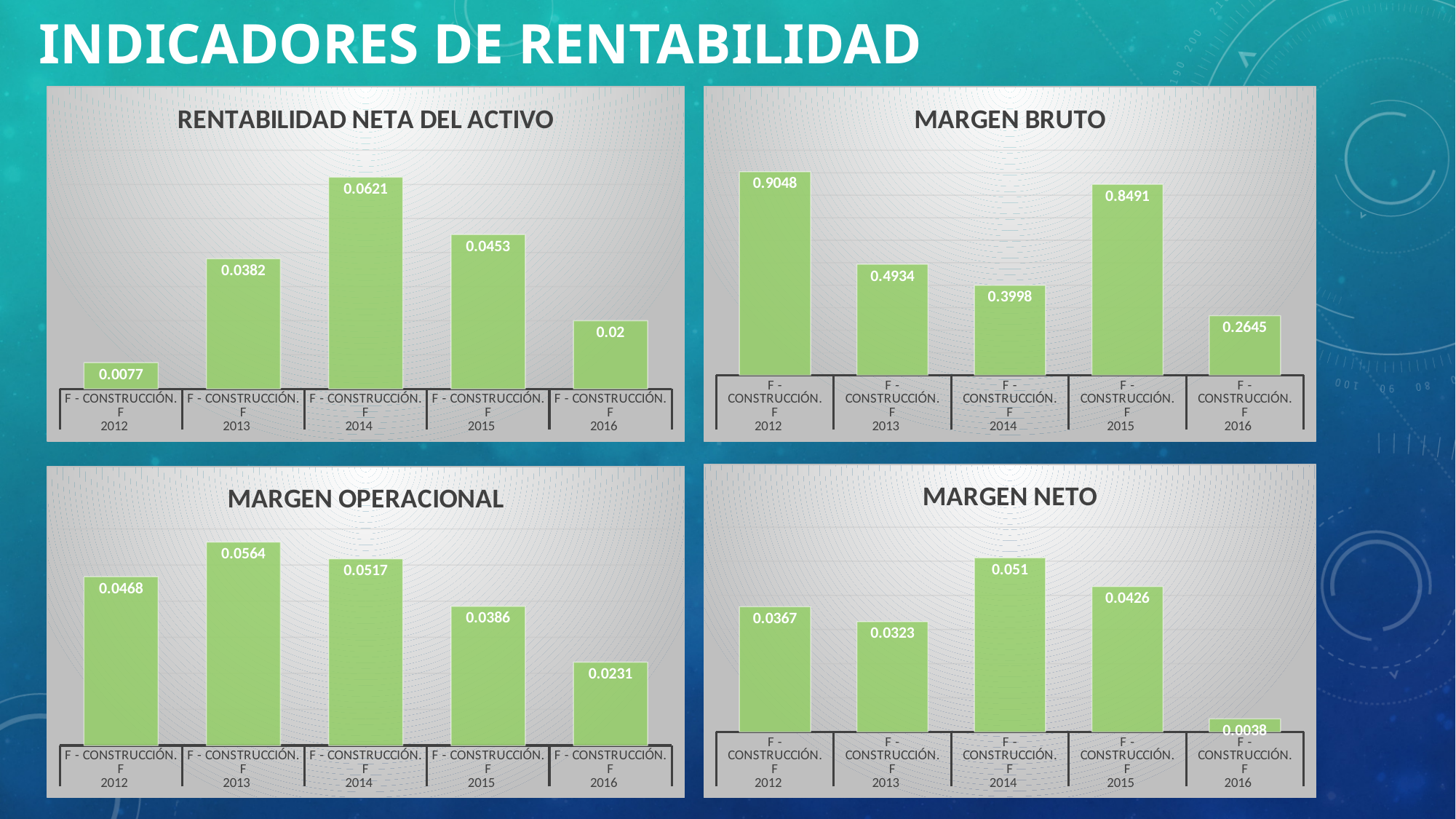
How many bars are in the MARGEN OPERACIONAL chart? 5 In the RENTABILIDAD NETA DEL ACTIVO chart, which year has the lowest value? 2012 In the MARGEN BRUTO chart, what is the difference between the values for 2012 and 2016? 0.6403 In the MARGEN NETO chart, what is the value for 2016? 0.0038 In the MARGEN BRUTO chart, which year has the lowest value? 2016 In the MARGEN OPERACIONAL chart, which year has the highest value? 2013 In the MARGEN NETO chart, which is larger, the value for 2014 or the value for 2015? 2014 In the RENTABILIDAD NETA DEL ACTIVO chart, what is the value for 2014? 0.0621 In the MARGEN BRUTO chart, what is the value for 2013? 0.4934 What type of chart is the MARGEN NETO chart? Bar chart In the MARGEN OPERACIONAL chart, what is the difference between the values for 2013 and 2016? 0.0333 In the MARGEN OPERACIONAL chart, do the values rise or fall from 2013 to 2016? Fall